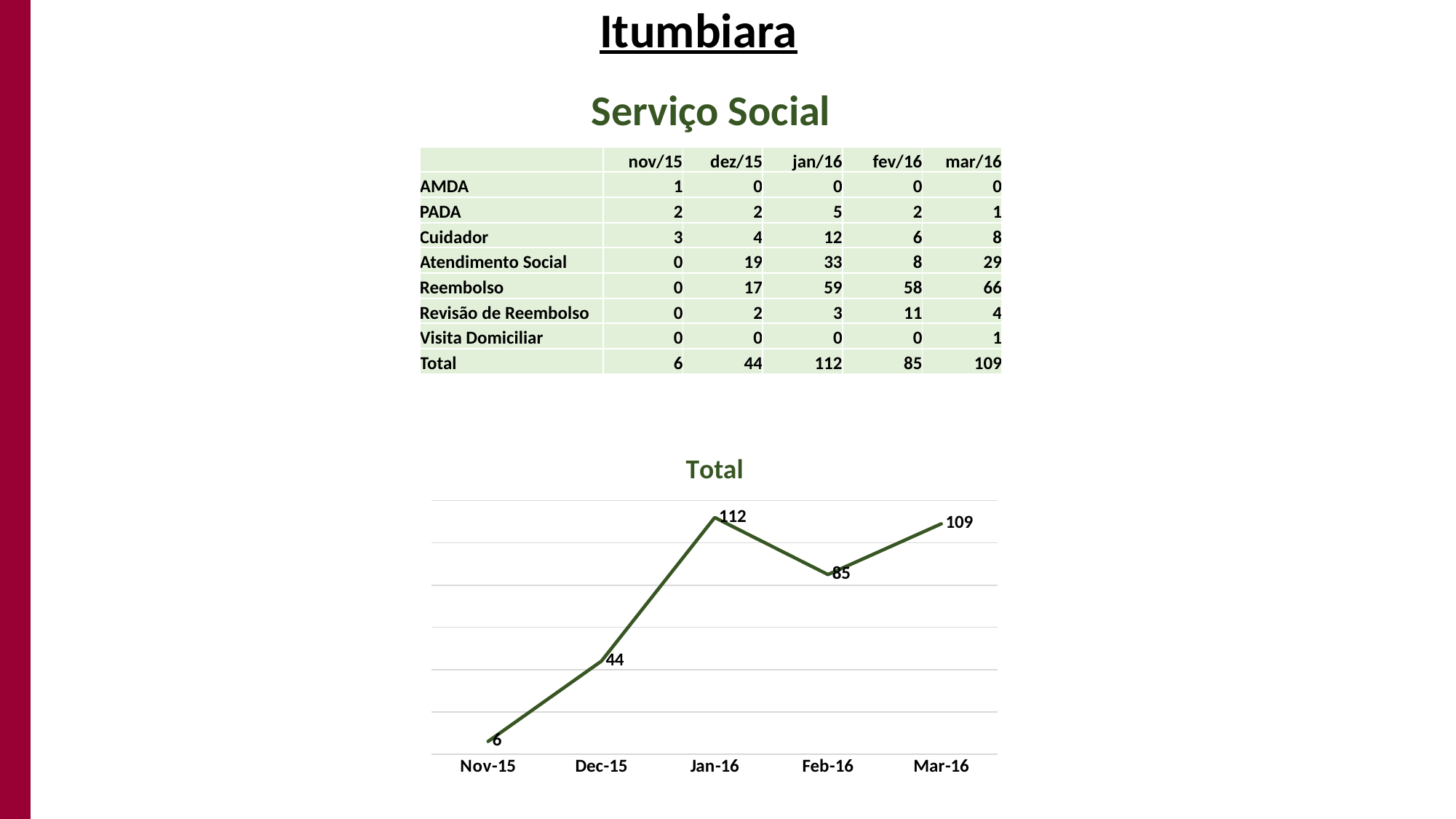
What type of chart is shown on the slide? line chart What is the difference between the values for Jan-16 and Feb-16? 27 What is the value for Dec-15 in the chart? 44 Which month has the lowest value in the chart? Nov-15 What is the difference between the values for Dec-15 and Nov-15? 38 How many data points are plotted in the chart? 5 What is the title of the chart? Total What is the value for Feb-16 in the chart? 85 Does the value rise or fall from Nov-15 to Jan-16? rise What is the value for Jan-16 in the chart? 112 Which month has the highest value in the chart? Jan-16 Which is larger, the value for Mar-16 or the value for Feb-16? Mar-16